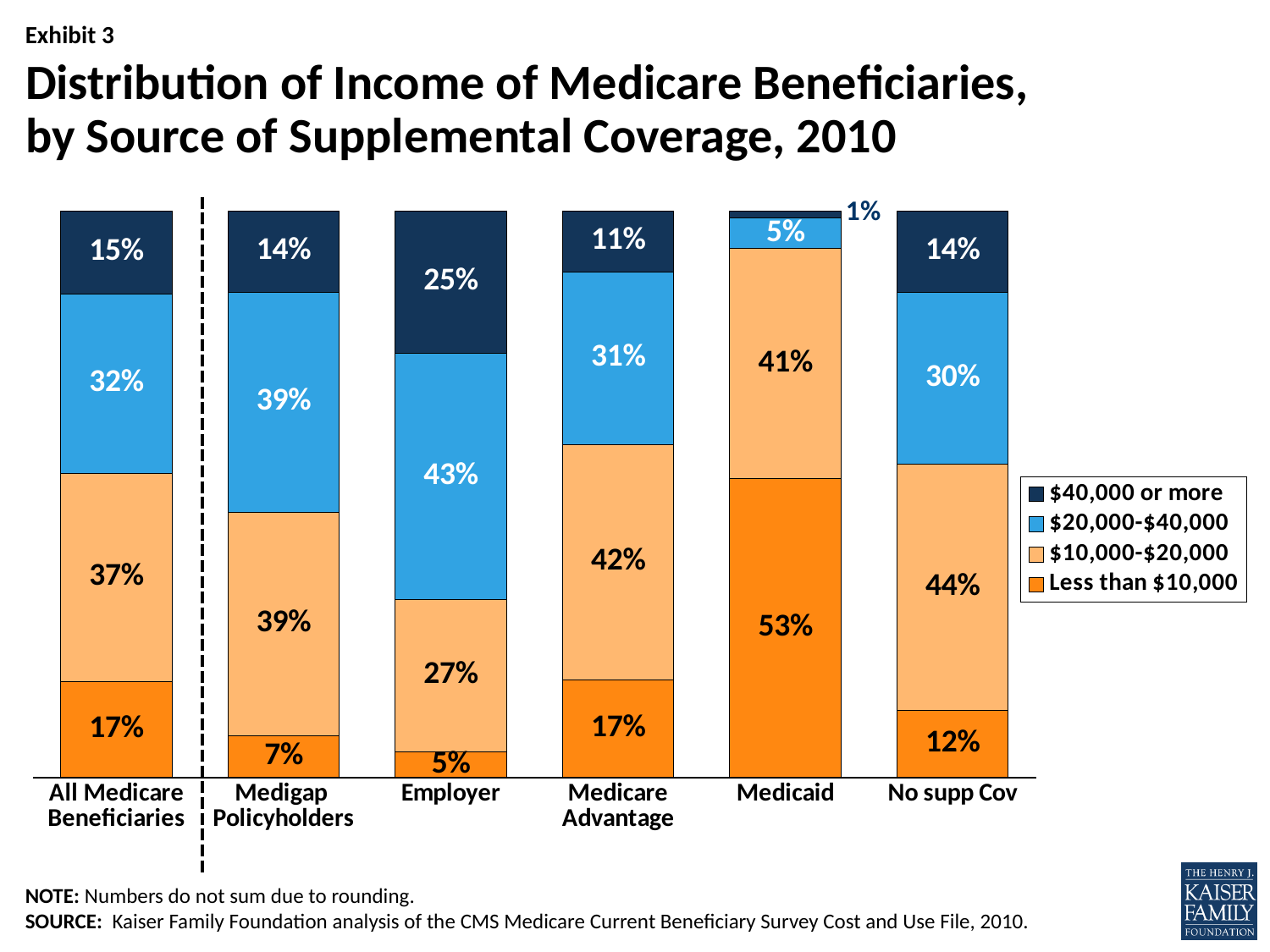
What percentage of Employer-covered beneficiaries have income of $40,000 or more? 25% What type of chart is shown on the slide? Stacked bar chart What is the value of the $20,000-$40,000 segment for Medigap Policyholders? 39% What share of Medicaid beneficiaries have income of less than $10,000? 53% Which legend entry is shown in dark navy blue? $40,000 or more What is the difference between the Less than $10,000 share for All Medicare Beneficiaries and for Employer? 12% What share of beneficiaries with No supp Cov have income of $10,000-$20,000? 44% Which is larger: the $20,000-$40,000 share for Employer or for Medicare Advantage? Employer Which category has the lowest share of beneficiaries with income of $40,000 or more? Medicaid How many coverage categories are shown along the x axis? 6 Which source of supplemental coverage has the highest share of beneficiaries with income less than $10,000? Medicaid How many income groups does the legend list? 4